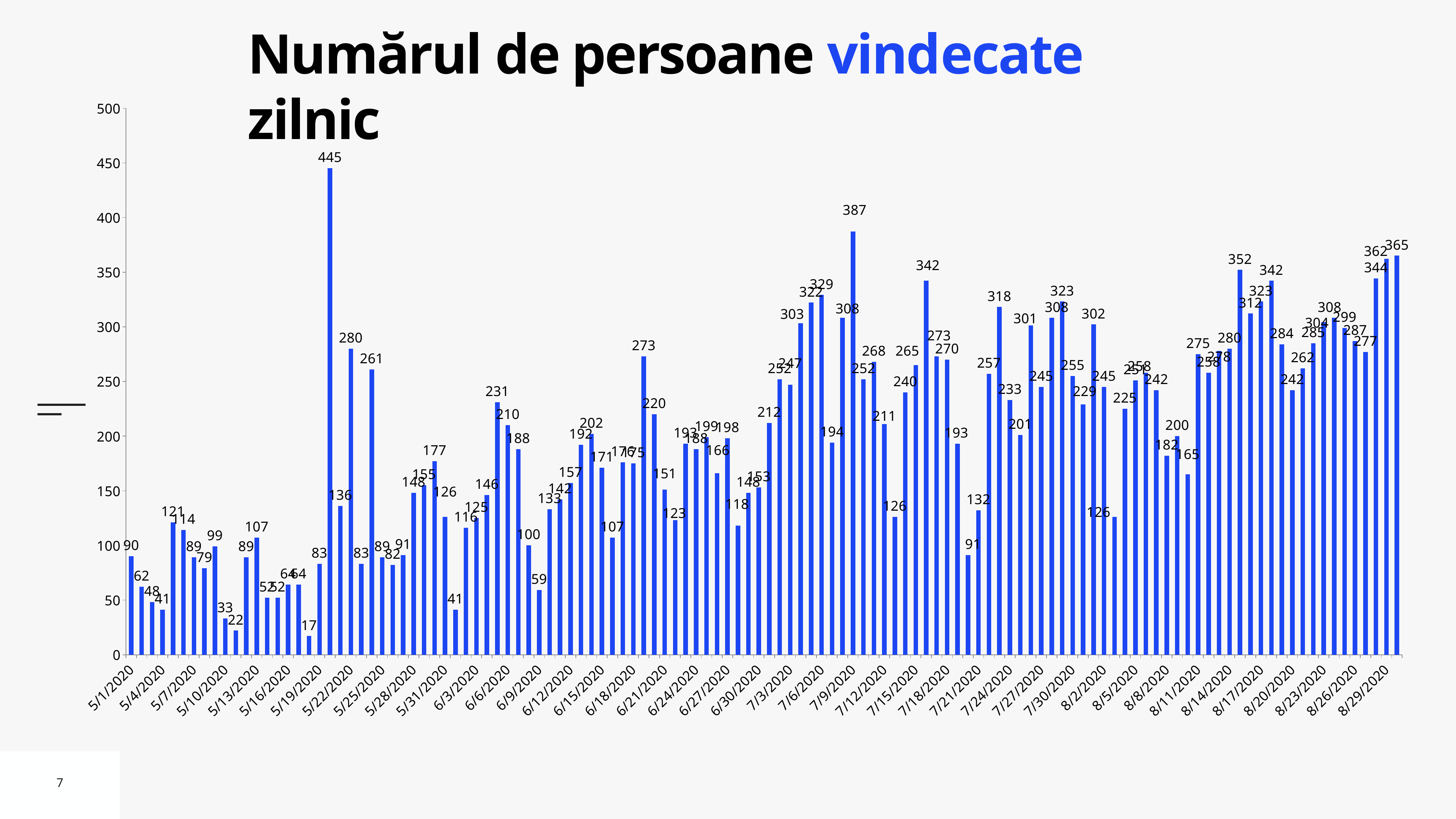
Which is larger, the tallest bar in May (445) or the tallest bar in July (387)? 445 Overall, do the values tend to rise or fall from May to August along the x axis? rise What is the value of the rightmost (last) bar in the chart? 365 What is the value of the first bar, for 5/1/2020? 90 What is the difference between the highest value (445) and the lowest value (17)? 428 Is the value of the tallest bar greater or less than 400? greater Is the value of the first bar (5/1/2020) greater or less than 100? less What is the second-highest value shown in the chart? 387 What type of chart is shown on the slide? bar chart What is the title of the chart? Numărul de persoane vindecate zilnic What is the lowest value shown in the chart? 17 What is the highest value shown in the chart? 445